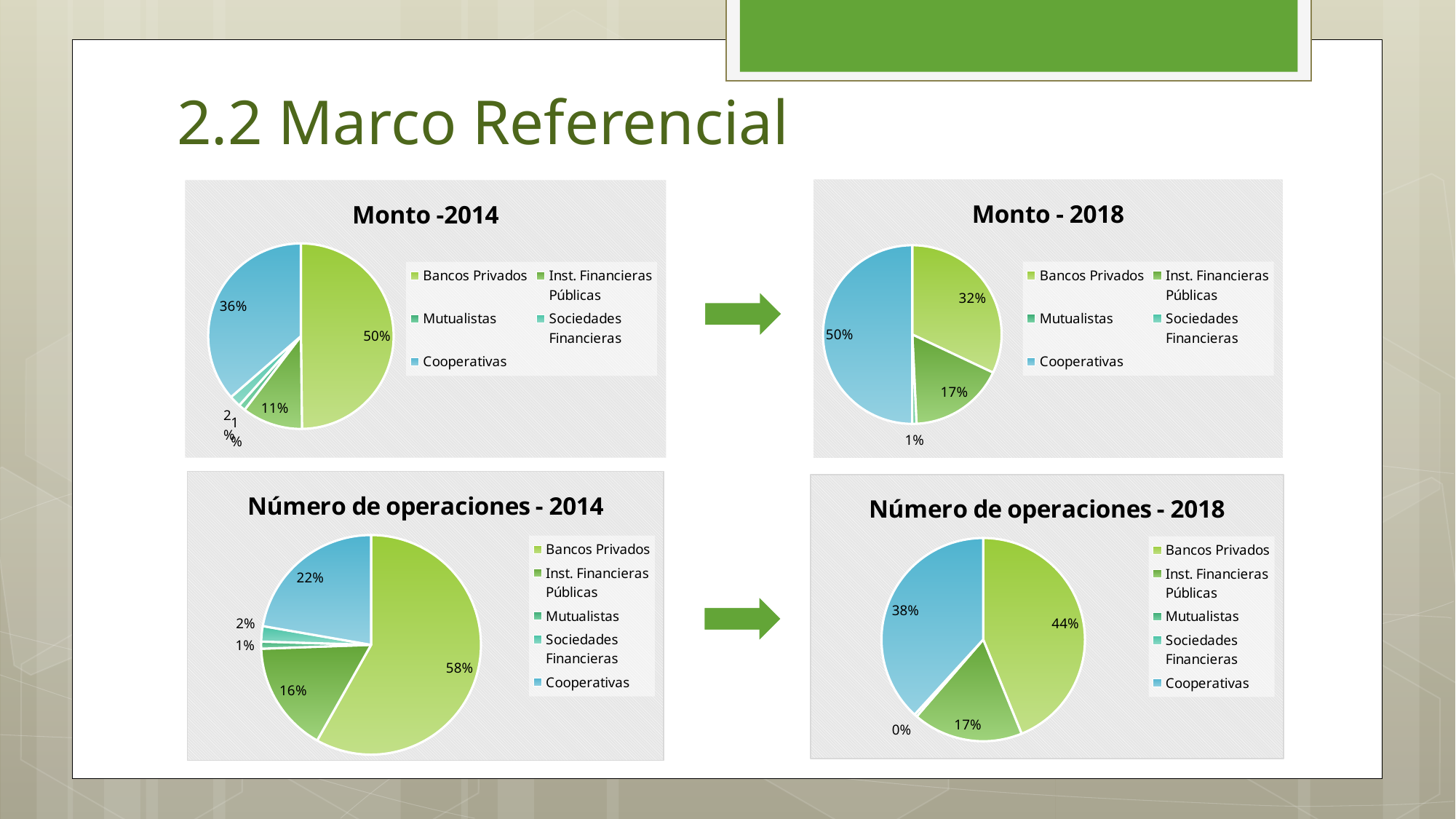
In the 'Monto -2014' chart, what share does Cooperativas have? 36% In the 'Monto - 2018' chart, which category has the largest share? Cooperativas In the 'Monto -2014' chart, what share does Inst. Financieras Públicas have? 11% In the 'Monto - 2018' chart, what share does Bancos Privados have? 32% In the 'Número de operaciones - 2018' chart, what share does Inst. Financieras Públicas have? 17% In the 'Número de operaciones - 2014' chart, what share does Bancos Privados have? 58% In the 'Número de operaciones - 2014' chart, what share does Cooperativas have? 22% In the 'Número de operaciones - 2018' chart, which is larger, Bancos Privados or Cooperativas? Bancos Privados What type of chart is 'Monto - 2018'? Pie chart In the 'Monto - 2018' chart, what is the difference between the Cooperativas share and the Inst. Financieras Públicas share? 33% How many series does the legend of the 'Número de operaciones - 2018' chart list? 5 In the 'Monto -2014' chart, what share does Bancos Privados have? 50%